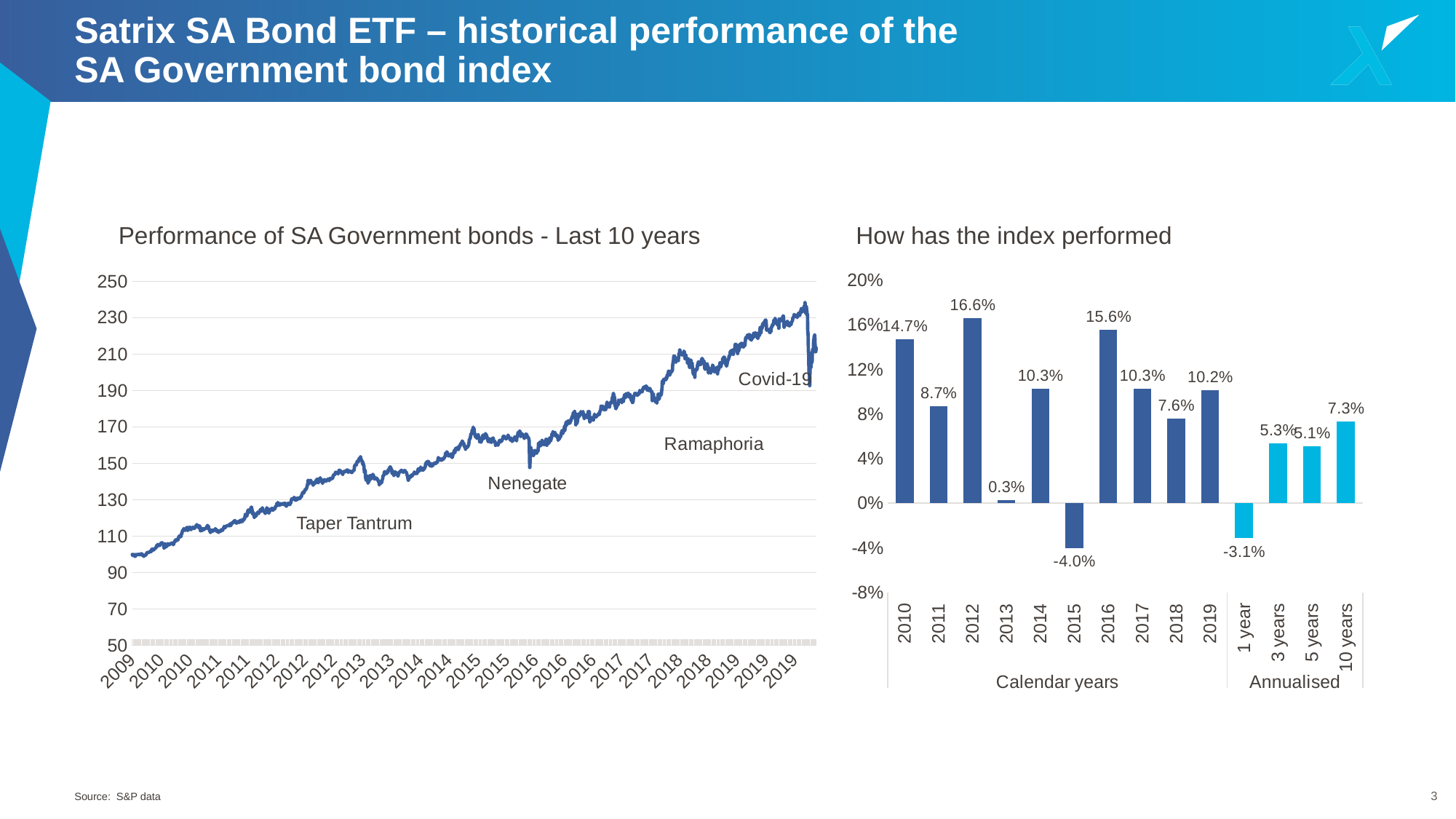
In the chart titled "How has the index performed", what was the return for 2015? -4.0% In the chart titled "How has the index performed", how many calendar years are shown? 10 In the chart titled "How has the index performed", what was the return for 2012? 16.6% In the chart titled "Performance of SA Government bonds - Last 10 years", does the index generally rise or fall from 2009 to 2019? Rise In the chart titled "How has the index performed", which calendar year had the highest return? 2012 In the chart titled "Performance of SA Government bonds - Last 10 years", is the peak value reached in 2019 greater or less than 230? greater What kind of chart is the chart titled "Performance of SA Government bonds - Last 10 years"? Line chart In the chart titled "How has the index performed", what is the difference between the 2016 return and the 2018 return? 8.0% In the chart titled "How has the index performed", what is the 10 years annualised return? 7.3% What kind of chart is the chart titled "How has the index performed"? Bar chart In the chart titled "How has the index performed", which calendar year had the lowest return? 2015 In the chart titled "How has the index performed", which is larger, the 2010 return or the 2011 return? 2010